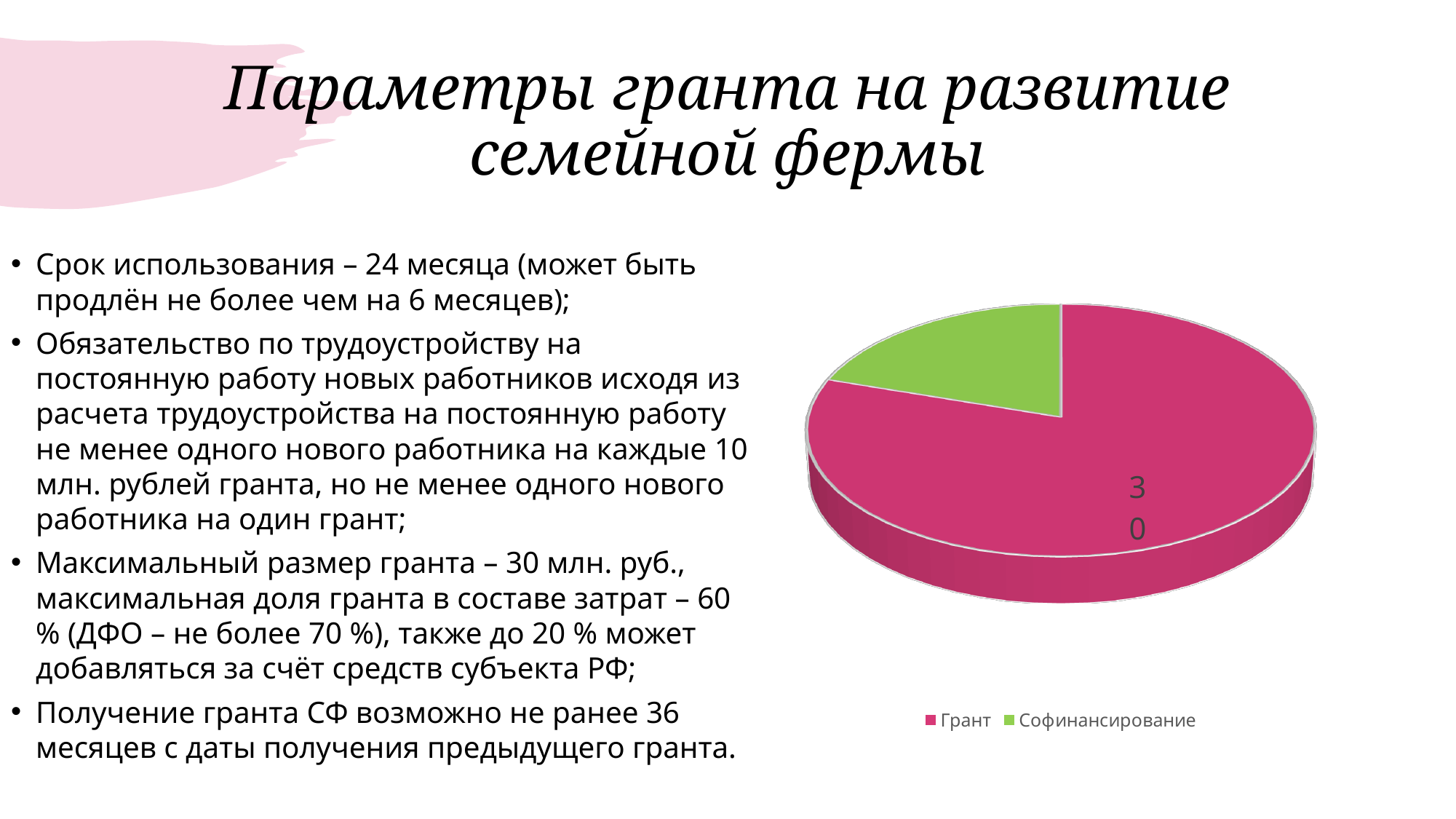
What colour is the Софинансирование slice in the pie chart? green What kind of chart is shown on the slide? pie chart What are the two legend entries of the pie chart? Грант, Софинансирование Which slice of the pie chart is the smallest? Софинансирование Which slice of the pie chart is the largest? Грант What value is printed on the Грант slice of the pie chart? 30 Which is larger in the pie chart, Грант or Софинансирование? Грант How many entries does the legend of the pie chart list? 2 How many slices does the pie chart have? 2